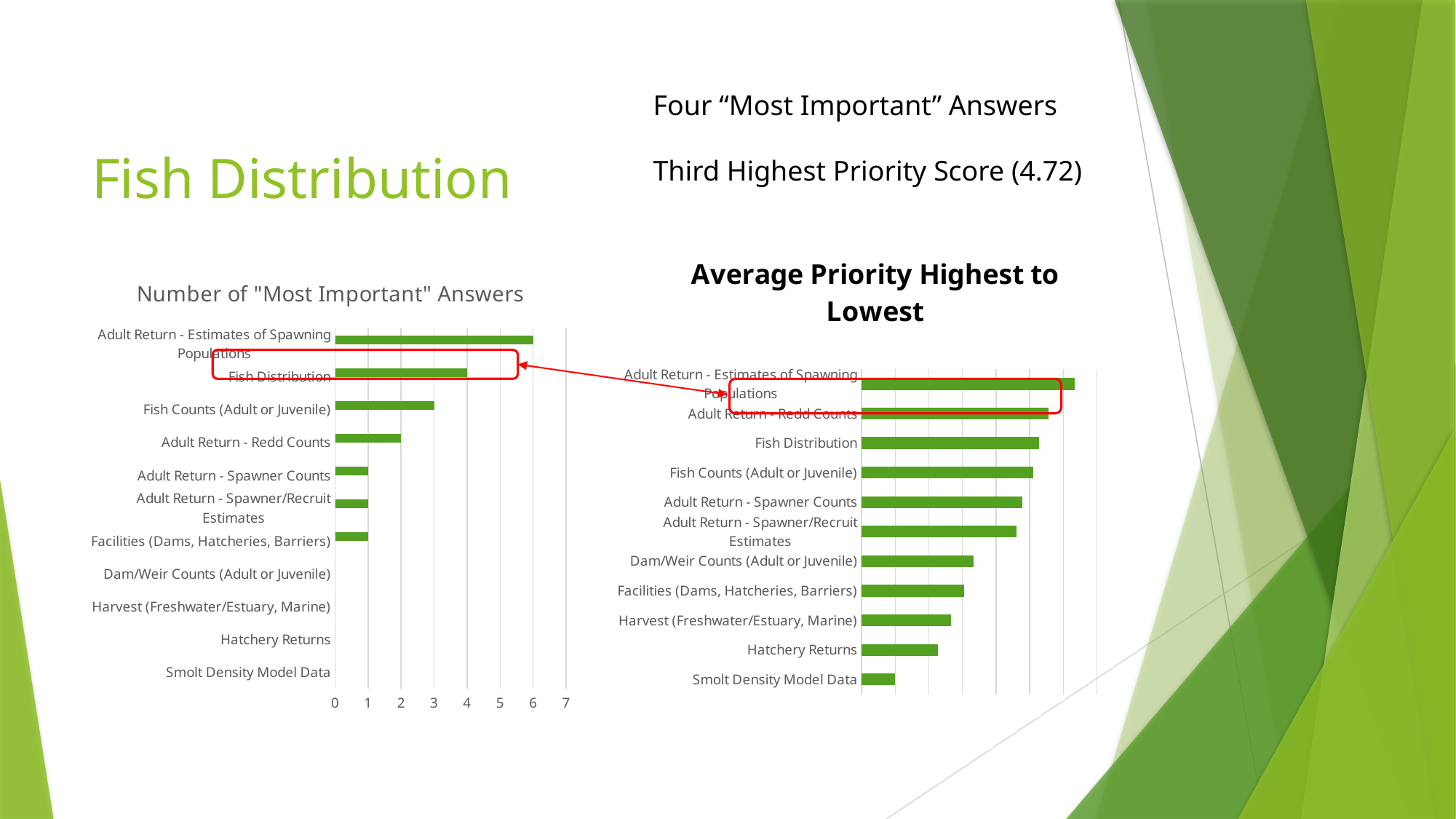
In the "Number of "Most Important" Answers" chart, what is the value for Adult Return - Estimates of Spawning Populations? 6 In the "Number of "Most Important" Answers" chart, how many "Most Important" answers did Fish Distribution receive? 4 In the "Average Priority Highest to Lowest" chart, which category has the lowest average priority? Smolt Density Model Data In the "Number of "Most Important" Answers" chart, which is larger: Fish Counts (Adult or Juvenile) or Adult Return - Redd Counts? Fish Counts (Adult or Juvenile) In the "Number of "Most Important" Answers" chart, what is the difference between Adult Return - Estimates of Spawning Populations and Fish Distribution? 2 In the "Average Priority Highest to Lowest" chart, which category has the highest average priority? Adult Return - Estimates of Spawning Populations In the "Average Priority Highest to Lowest" chart, which is larger: Hatchery Returns or Harvest (Freshwater/Estuary, Marine)? Harvest (Freshwater/Estuary, Marine) How many categories are listed in the "Number of "Most Important" Answers" chart? 11 What is the title of the chart on the right side of the slide? Average Priority Highest to Lowest In the "Number of "Most Important" Answers" chart, which category has the highest value? Adult Return - Estimates of Spawning Populations What type of chart is the "Number of "Most Important" Answers" chart? Bar chart In the "Number of "Most Important" Answers" chart, what is the value for Fish Counts (Adult or Juvenile)? 3